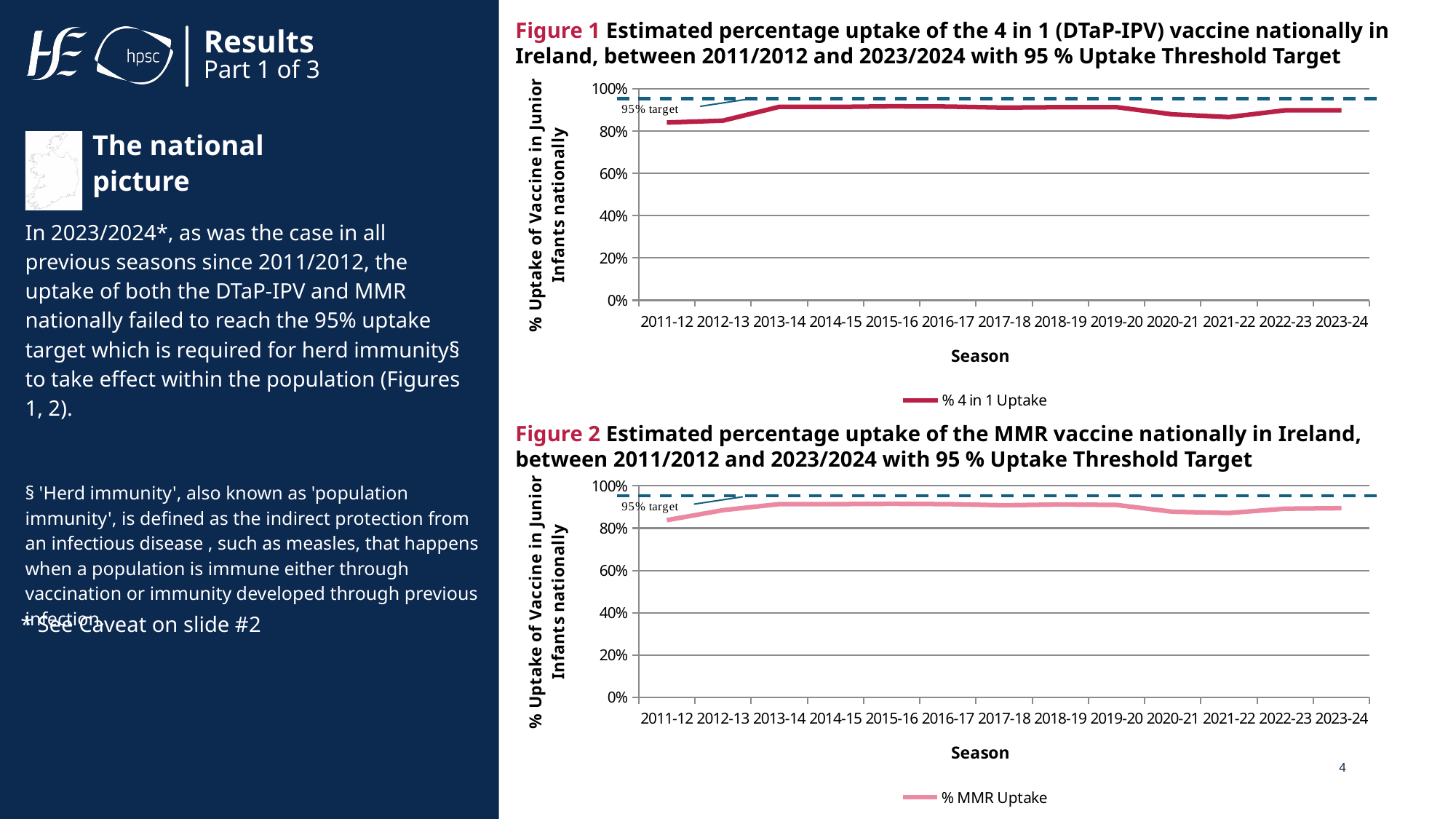
In Figure 1, which season has the lowest % 4 in 1 Uptake? 2011-12 In Figure 1, what kind of chart is used to show the 4 in 1 uptake? line chart In Figure 1, what target level is marked by the dashed line? 95% target In Figure 2, how many seasons are shown on the x axis? 13 In Figure 2, does the % MMR Uptake rise or fall from 2019-20 to 2020-21? fall In Figure 2, is the % MMR Uptake for 2015-16 greater or less than 80%? greater In Figure 1, is the % 4 in 1 Uptake for 2023-24 greater or less than 100%? less In Figure 2, what series name is shown in the legend? % MMR Uptake In Figure 1, is the % 4 in 1 Uptake for 2013-14 greater or less than 60%? greater In Figure 2, which season has the lowest % MMR Uptake? 2011-12 In Figure 1, does the % 4 in 1 Uptake rise or fall from 2011-12 to 2013-14? rise